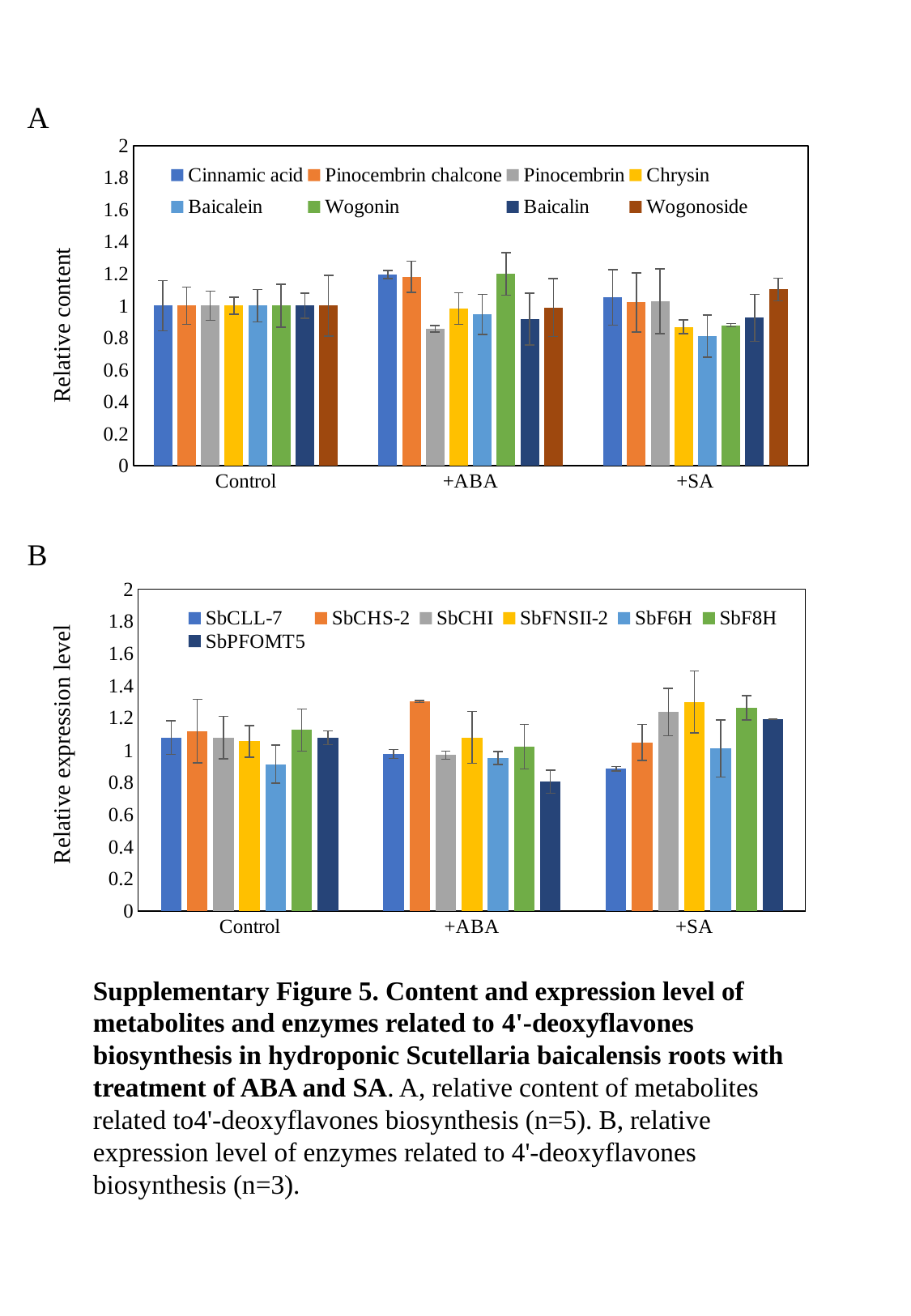
How many treatment categories are shown on the x axis of chart B? 3 In chart A, is the value for Wogonin under +ABA greater or less than 1? greater What is the y-axis label of chart B? Relative expression level In chart B, which series has the lowest value under +SA? SbCLL-7 In chart B, is the value for SbPFOMT5 under +ABA greater or less than 1? less In chart B, is the value for SbCHS-2 under +ABA greater or less than 1.2? greater In chart A, under +ABA, which is larger: Cinnamic acid or Pinocembrin? Cinnamic acid In chart B, which series has the highest value under +ABA? SbCHS-2 How many series does the legend of chart B list? 7 How many series does the legend of chart A list? 8 What kind of chart is chart A? bar chart